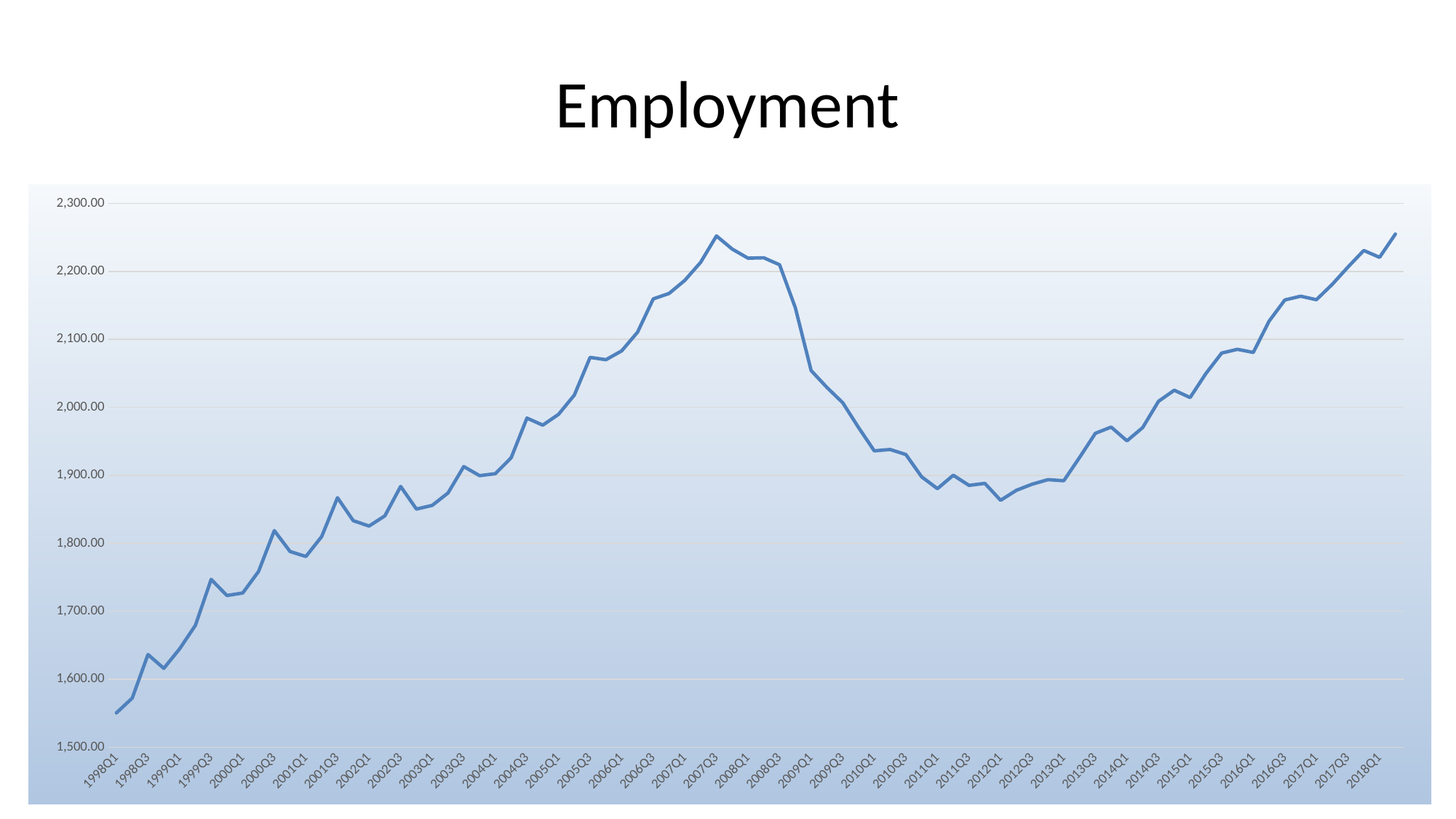
Which is larger, the value for 2007Q3 or the value for 2012Q1? 2007Q3 What kind of chart is shown on the slide? line chart What is the title of the chart? Employment Is the value for 2012Q1 greater or less than 1,900.00? less Which quarter has the lowest employment value on the chart? 1998Q1 Is the value for 2009Q1 greater or less than 2,000.00? greater Does the employment value rise or fall between 2007Q3 and 2012Q1? fall Is the value for 2018Q1 greater or less than 2,200.00? greater Does the employment value rise or fall between 2012Q1 and 2018Q1? rise